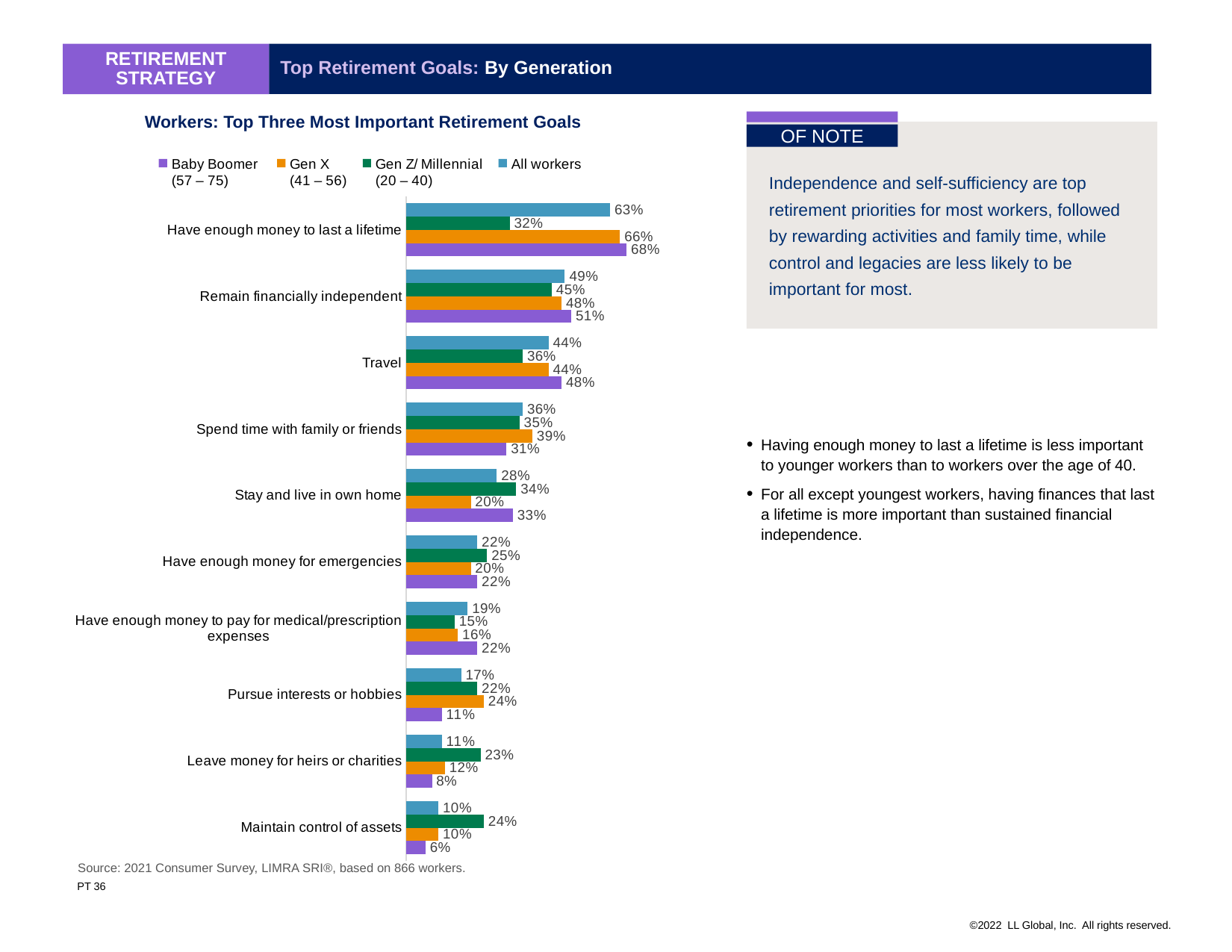
Which retirement goal has the highest All workers value? Have enough money to last a lifetime How many series does the legend list? 4 What percentage of Gen Z/Millennial workers cite Maintain control of assets as a top goal? 24% Which colour represents Gen X in the chart? Orange What percentage of Baby Boomers say having enough money to last a lifetime is a top retirement goal? 68% What type of chart is shown on the slide? Bar chart Which retirement goal has the lowest Baby Boomer value? Maintain control of assets What is the All workers value for Travel? 44% For Leave money for heirs or charities, which is larger: the Gen Z/Millennial value or the Baby Boomer value? Gen Z/Millennial What is the difference between the Gen X and Gen Z/Millennial values for Have enough money to last a lifetime? 34 percentage points What is the Gen X value for Stay and live in own home? 20% How many retirement goals are listed on the chart? 10